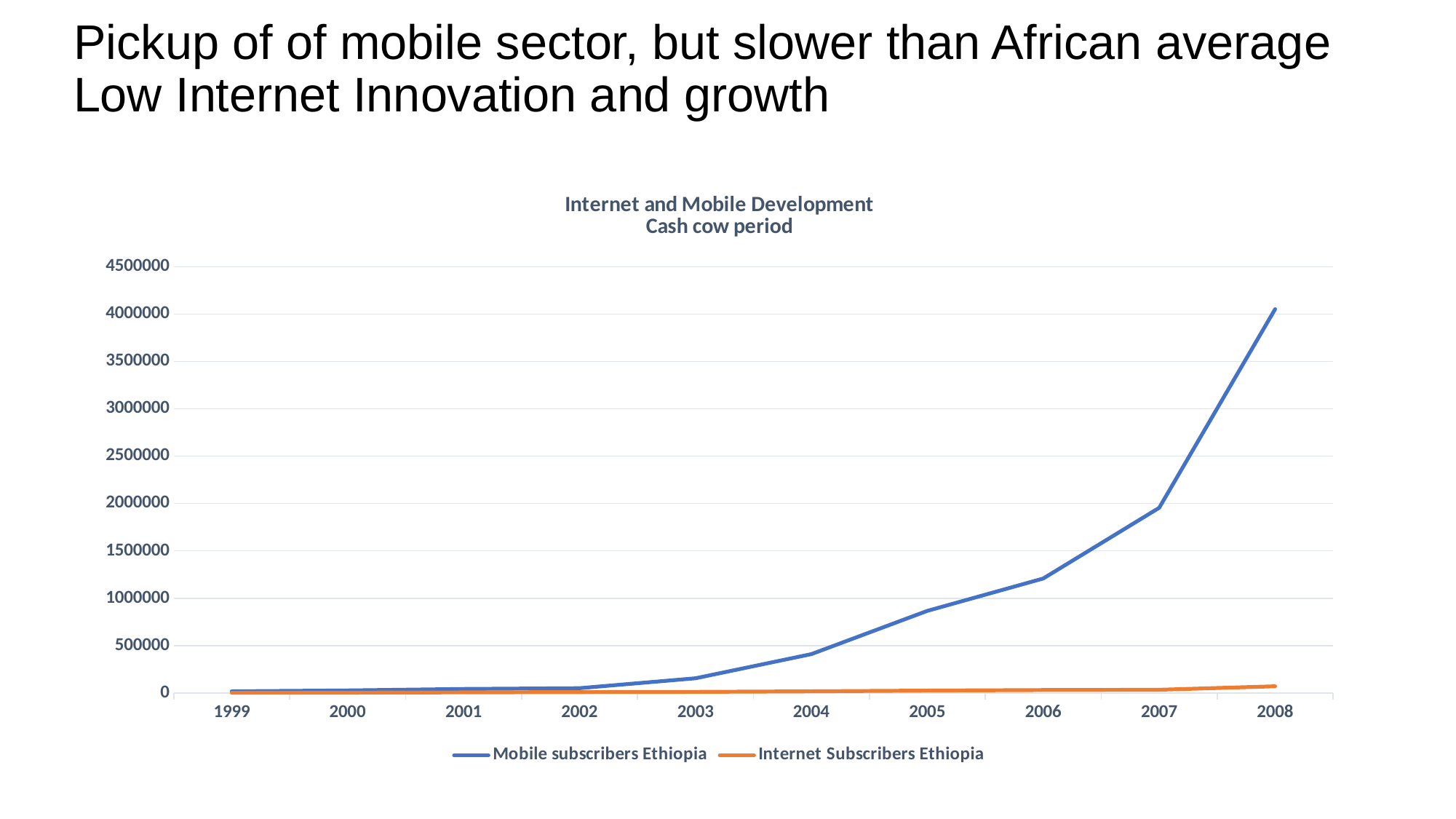
What kind of chart is shown on the slide? line chart In which year is the value for Mobile subscribers Ethiopia highest? 2008 In which year is the value for Mobile subscribers Ethiopia lowest? 1999 Which series is drawn in orange? Internet Subscribers Ethiopia What is the title of the chart? Internet and Mobile Development Cash cow period Do the values for Mobile subscribers Ethiopia rise or fall from 1999 to 2008? rise How many years are plotted along the x axis? 10 How many series does the legend list? 2 Is the value for Mobile subscribers Ethiopia in 2004 greater or less than 500000? less In 2008, which series has the larger value, Mobile subscribers Ethiopia or Internet Subscribers Ethiopia? Mobile subscribers Ethiopia Is the value for Mobile subscribers Ethiopia in 2008 greater or less than 3500000? greater Is the value for Mobile subscribers Ethiopia in 2006 greater or less than 1000000? greater